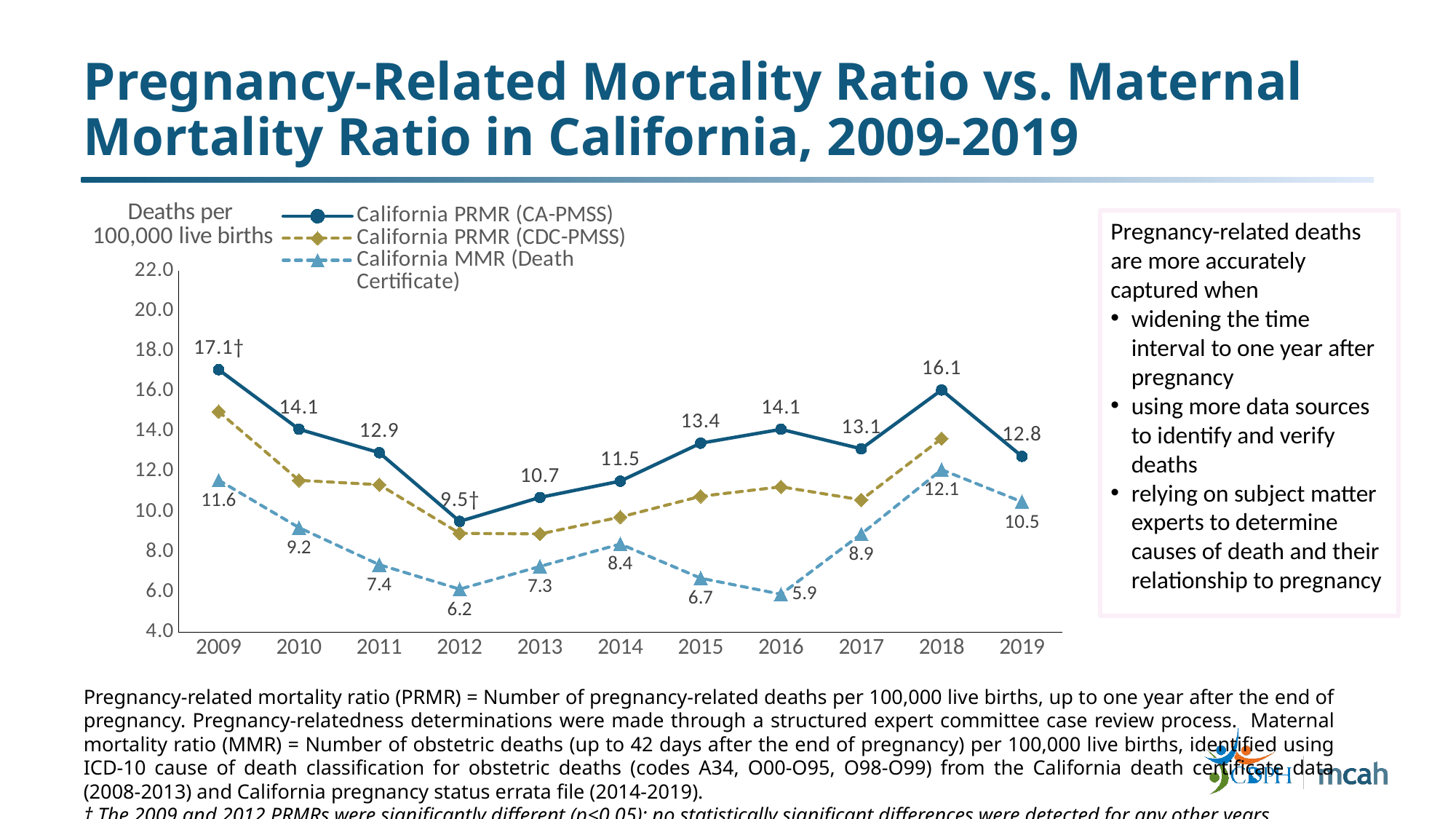
Is the California PRMR (CDC-PMSS) value for 2009 greater or less than 14.0? greater What kind of chart is shown on the slide? line chart What is the difference between the California MMR (Death Certificate) values for 2018 and 2017? 3.2 By how much did the California PRMR (CA-PMSS) fall from 2018 to 2019? 3.3 Does the California PRMR (CA-PMSS) rise or fall from 2009 to 2012? fall In which year is the California MMR (Death Certificate) lowest? 2016 How many years are shown on the x axis? 11 In which year is the California PRMR (CA-PMSS) highest? 2009 In 2009, which is larger: the California PRMR (CA-PMSS) or the California MMR (Death Certificate)? California PRMR (CA-PMSS) What is the California MMR (Death Certificate) value for 2016? 5.9 How many series does the legend list? 3 What is the California PRMR (CA-PMSS) value for 2018? 16.1